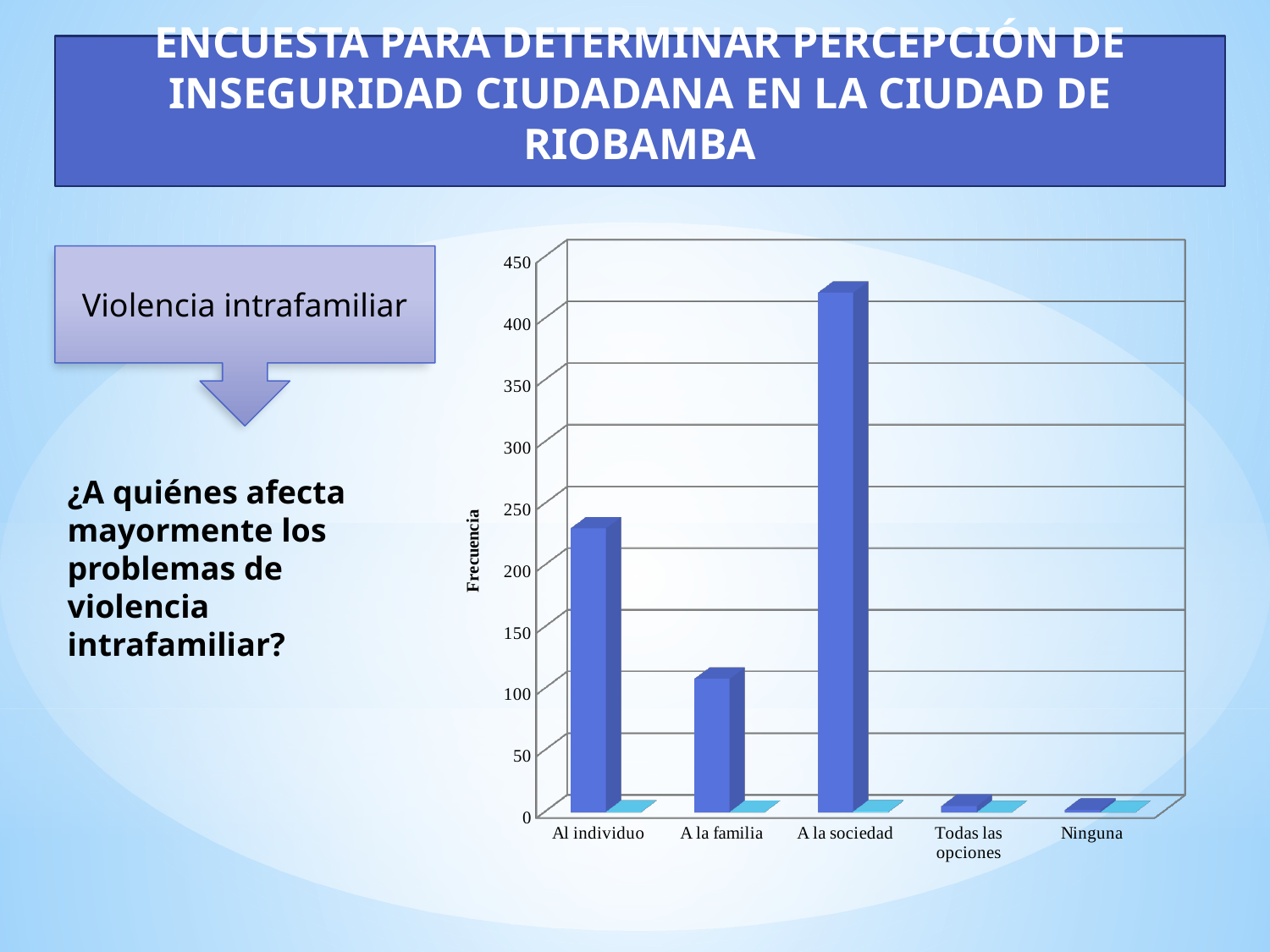
Which has a larger value, A la sociedad or Al individuo? A la sociedad Is the value for A la familia greater or less than 150? less What kind of chart is shown on the slide? bar chart Is the value for Al individuo greater or less than 200? greater How many categories are shown on the x axis of the chart? 5 Is the value for Al individuo greater or less than 250? less What is the title of the vertical axis of the chart? Frecuencia Which has a larger value, Al individuo or A la familia? Al individuo Which category has the highest value in the chart? A la sociedad What is the highest tick value shown on the vertical axis of the chart? 450